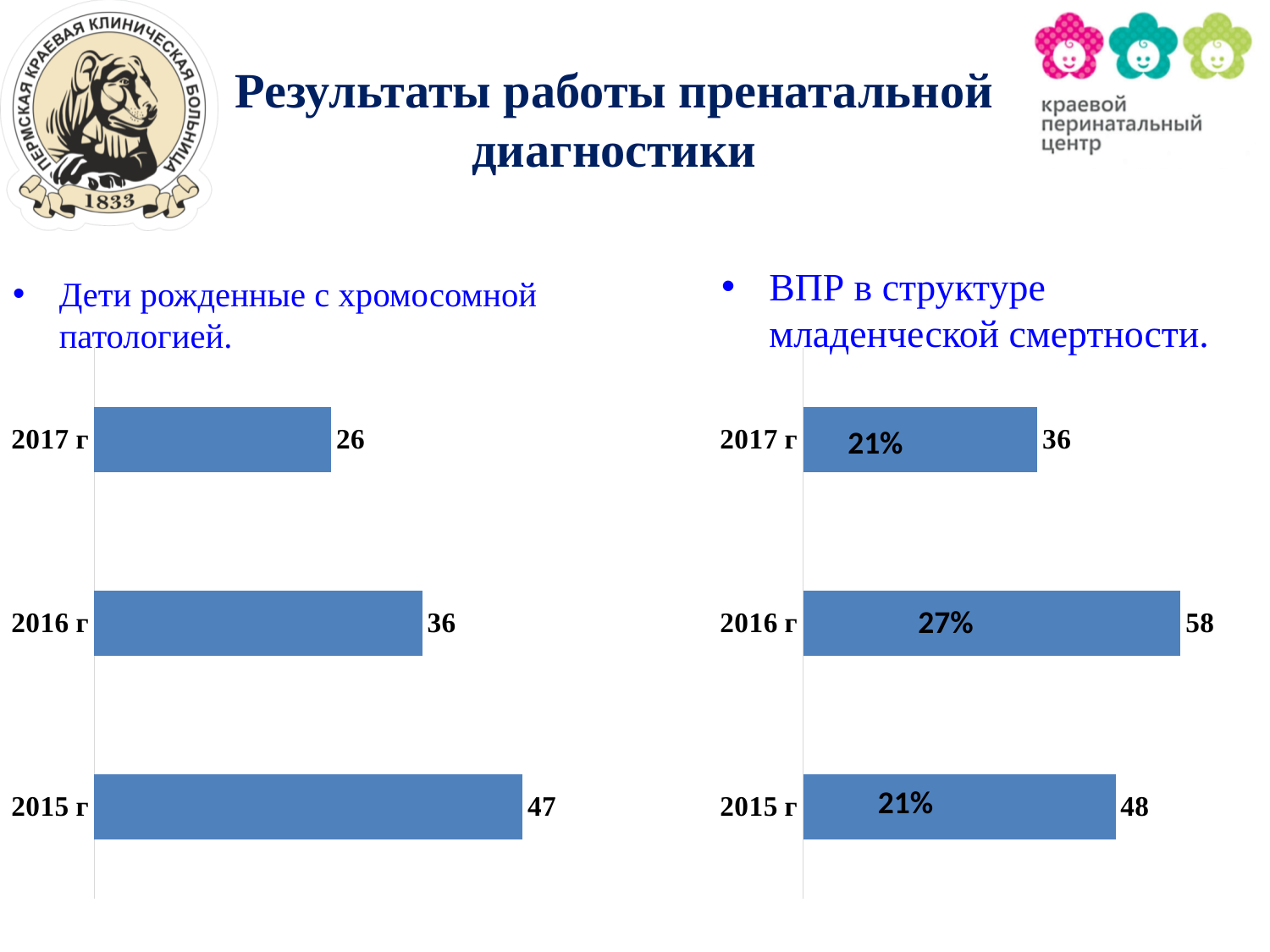
How many bars does the left chart (Дети рожденные с хромосомной патологией) have? 3 In the right chart (ВПР в структуре младенческой смертности), what is the value for 2016 г? 58 What type of chart is the right chart (ВПР в структуре младенческой смертности)? bar chart In the left chart (Дети рожденные с хромосомной патологией), what is the value for 2015 г? 47 In the right chart (ВПР в структуре младенческой смертности), what is the difference between the values for 2016 г and 2015 г? 10 In the left chart (Дети рожденные с хромосомной патологией), which year has the highest value? 2015 г In the left chart (Дети рожденные с хромосомной патологией), what is the value for 2017 г? 26 In the right chart (ВПР в структуре младенческой смертности), which year has the lowest value? 2017 г In the left chart (Дети рожденные с хромосомной патологией), what is the difference between the values for 2015 г and 2017 г? 21 In the left chart (Дети рожденные с хромосомной патологией), do the values rise or fall from 2015 г to 2017 г? fall In the right chart (ВПР в структуре младенческой смертности), what percentage is shown inside the bar for 2016 г? 27% In the right chart (ВПР в структуре младенческой смертности), which is larger: the value for 2015 г or 2017 г? 2015 г